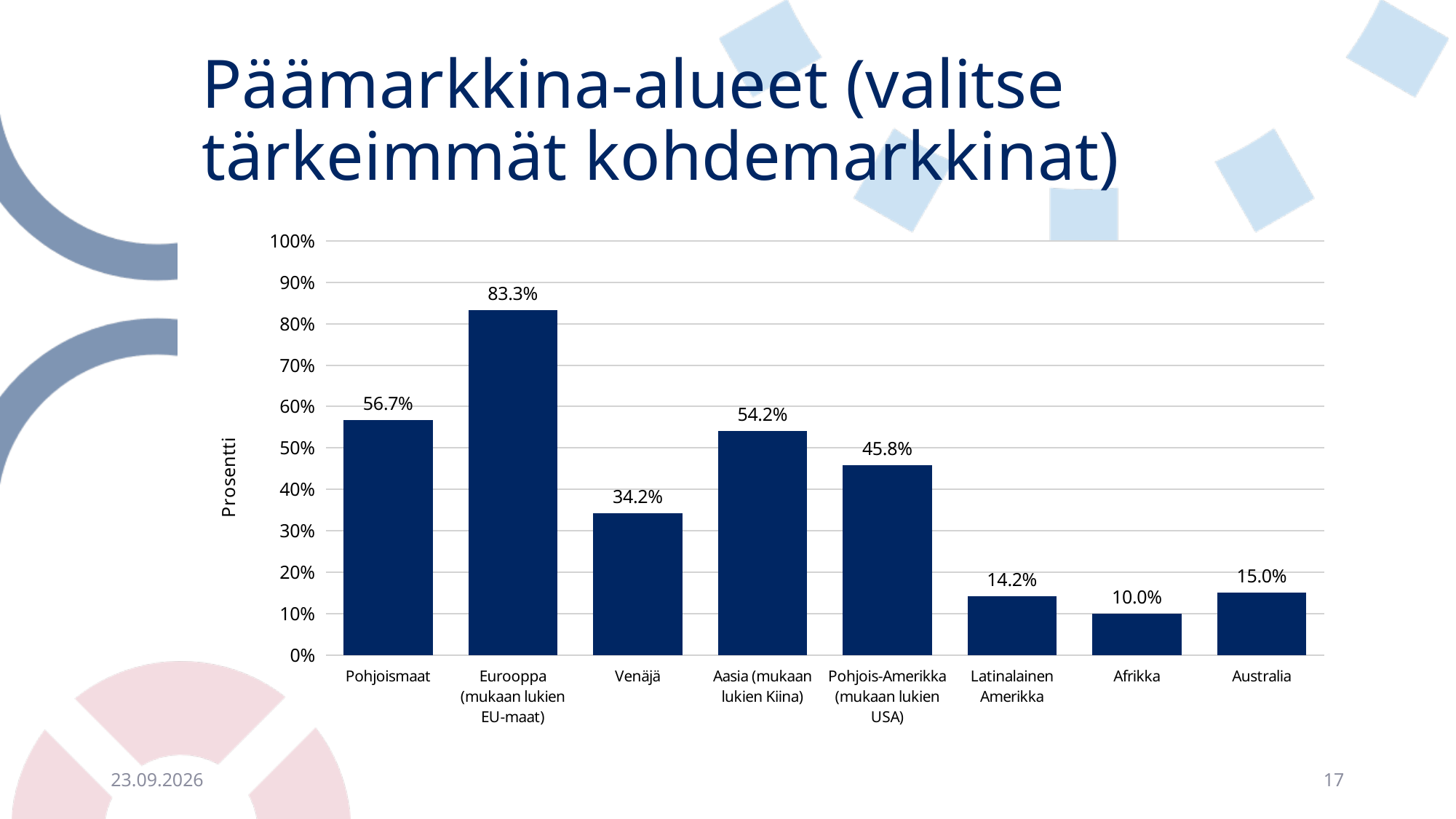
Which category has the highest value? Eurooppa (mukaan lukien EU-maat) Is the value for Pohjois-Amerikka (mukaan lukien USA) greater or less than 50%? less Which category has the lowest value? Afrikka How many categories are shown on the x axis? 8 What is the difference between the values for Eurooppa (mukaan lukien EU-maat) and Afrikka? 73.3% What is the value for Afrikka? 10.0% What is the value for Venäjä? 34.2% What kind of chart is shown on the slide? bar chart What is the label of the y axis? Prosentti Which is larger, the value for Latinalainen Amerikka or the value for Australia? Australia What is the difference between the values for Pohjoismaat and Aasia (mukaan lukien Kiina)? 2.5% What is the value for Eurooppa (mukaan lukien EU-maat)? 83.3%